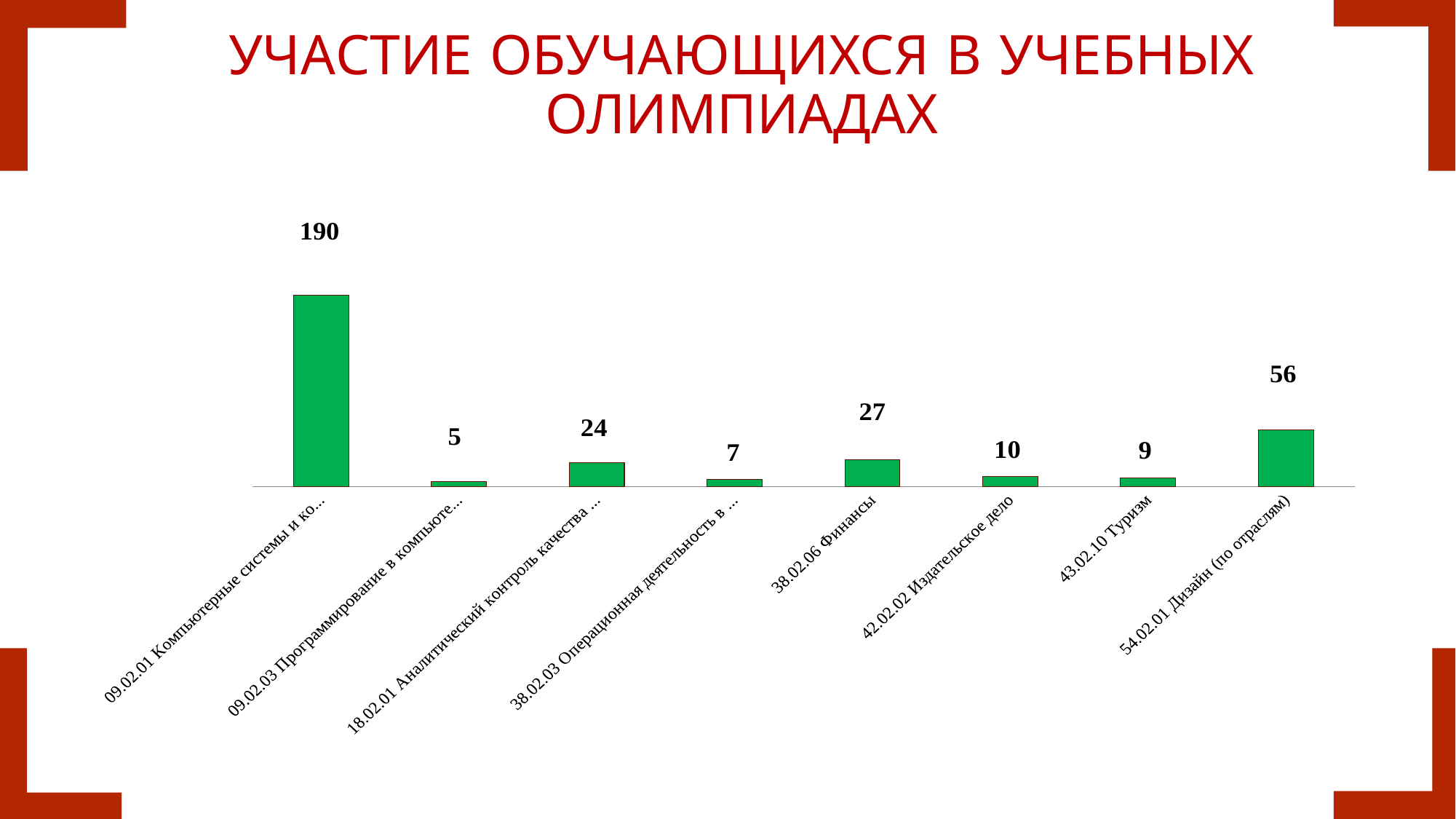
Which category has the highest value? 09.02.01 Компьютерные системы и ко... How many categories are shown in the chart? 8 What kind of chart is shown on the slide? Bar chart What is the value for 54.02.01 Дизайн (по отраслям)? 56 Which is larger: the value for 42.02.02 Издательское дело or the value for 43.02.10 Туризм? 42.02.02 Издательское дело What is the value for 38.02.06 Финансы? 27 What is the title of the slide? УЧАСТИЕ ОБУЧАЮЩИХСЯ В УЧЕБНЫХ ОЛИМПИАДАХ What colour are the bars in the chart? Green What is the difference between the values for 54.02.01 Дизайн (по отраслям) and 38.02.06 Финансы? 29 What is the value for 43.02.10 Туризм? 9 Which category has the lowest value? 09.02.03 Программирование в компьюте... What is the value for 42.02.02 Издательское дело? 10